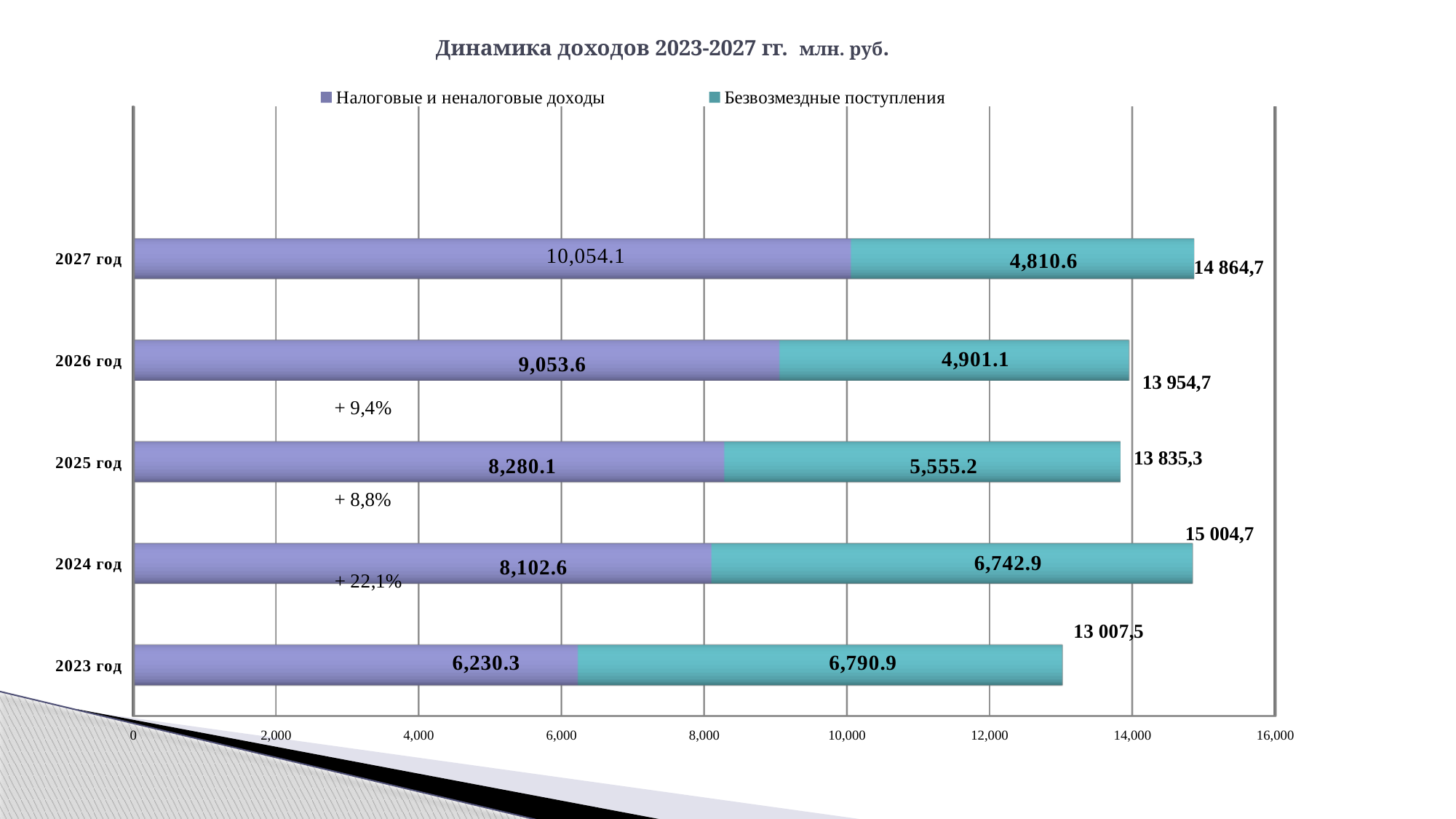
Which is larger: Безвозмездные поступления in 2024 год or in 2025 год? 2024 год Which year has the lowest value of Налоговые и неналоговые доходы? 2023 год What kind of chart is shown on the slide? Stacked bar chart Which year has the highest value of Налоговые и неналоговые доходы? 2027 год What is the total of the stacked bar for 2027 год? 14 864,7 How many series does the legend list? 2 What is the difference between Налоговые и неналоговые доходы in 2027 год and 2026 год? 1,000.5 Which year has the lowest value of Безвозмездные поступления? 2027 год How many years are shown on the chart? 5 Do the values of Налоговые и неналоговые доходы rise or fall from 2023 год to 2027 год? Rise What is the value of Налоговые и неналоговые доходы for 2027 год? 10,054.1 What is the value of Безвозмездные поступления for 2023 год? 6,790.9